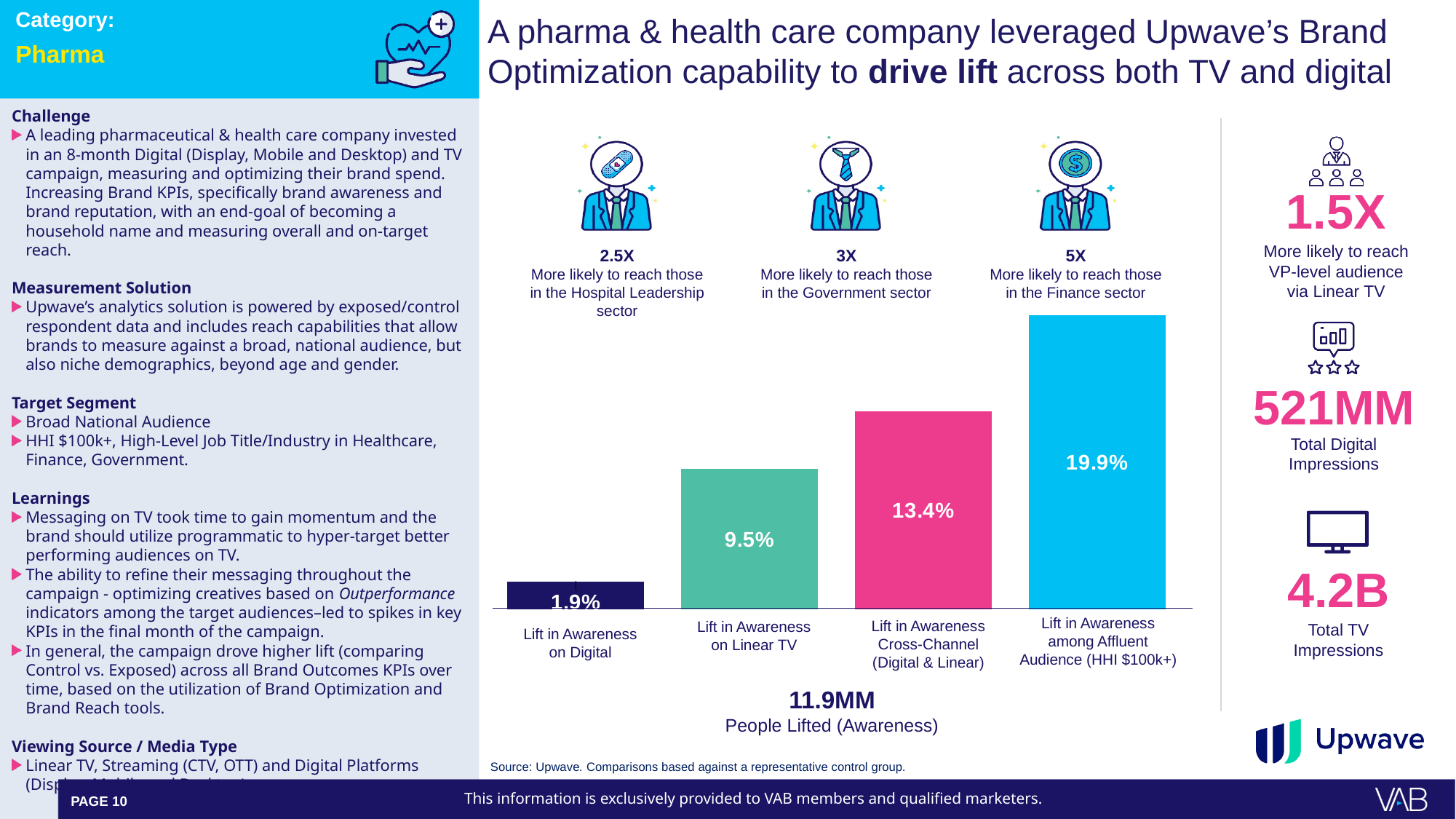
What is the difference between the lift in awareness among the Affluent Audience and the Cross-Channel lift in awareness? 6.5% What is the value for Lift in Awareness on Digital? 1.9% What kind of chart is shown on the slide? Bar chart What is the difference between the lift in awareness on Linear TV and the lift in awareness on Digital? 7.6% What is the value for Lift in Awareness among Affluent Audience (HHI $100k+)? 19.9% What is the value for Lift in Awareness Cross-Channel (Digital & Linear)? 13.4% Which category has the highest lift in awareness? Lift in Awareness among Affluent Audience (HHI $100k+) Do the bar values rise or fall from left to right across the chart? Rise Which is larger, the lift in awareness on Linear TV or the Cross-Channel lift in awareness? Lift in Awareness Cross-Channel (Digital & Linear) What is the value for Lift in Awareness on Linear TV? 9.5% How many bars are shown in the chart? 4 Which category has the lowest lift in awareness? Lift in Awareness on Digital